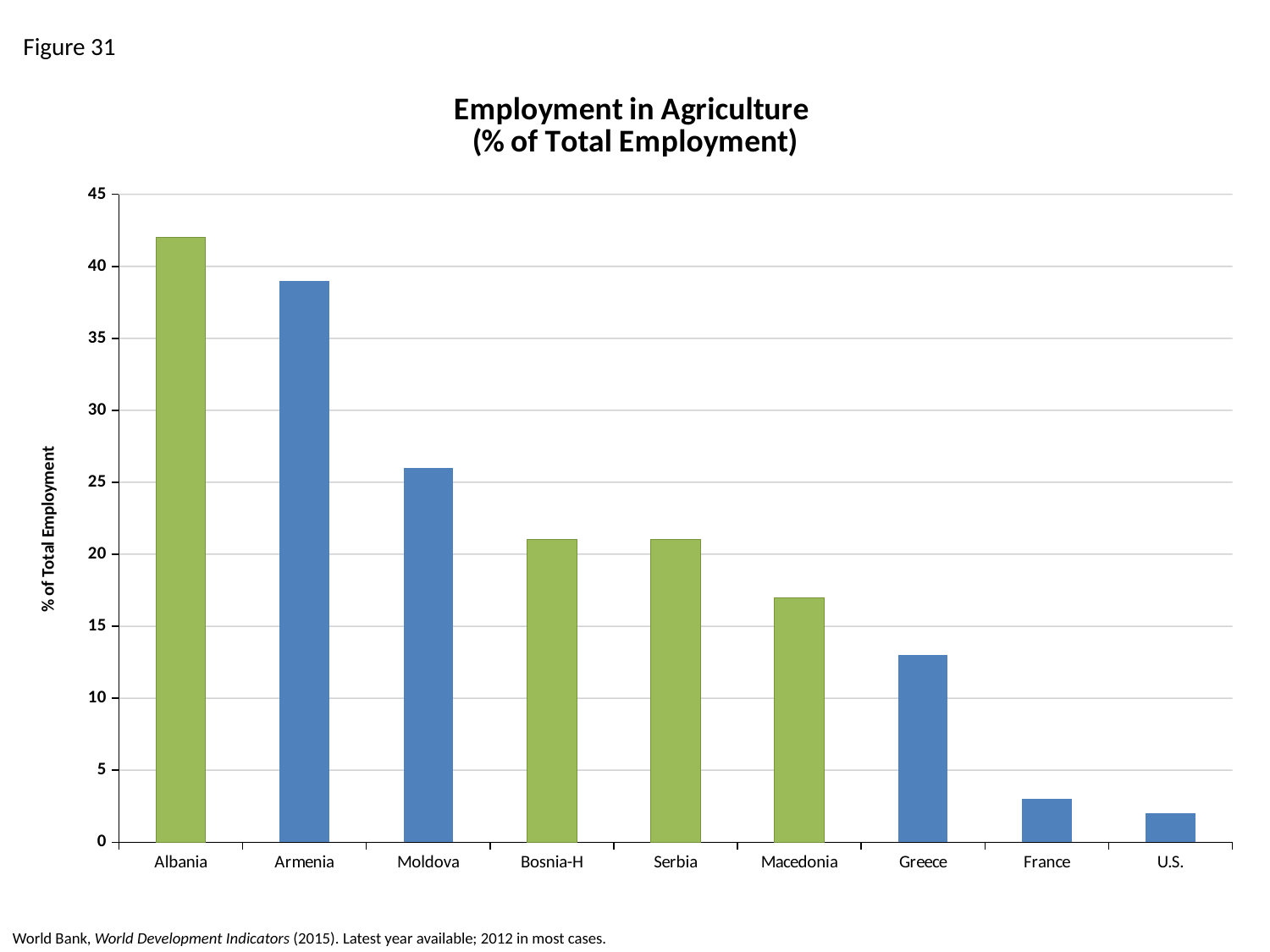
Which country has the highest employment in agriculture? Albania Is the value for Macedonia greater or less than 20? less What kind of chart is shown on the slide? bar chart What is the label on the vertical axis? % of Total Employment Is the value for Albania greater or less than 40? greater Do the values rise or fall moving from left to right along the x axis? fall Is the value for Armenia greater or less than 40? less How many countries are shown on the x axis? 9 Which country has the lowest employment in agriculture? U.S. Which has a higher value, Moldova or Greece? Moldova